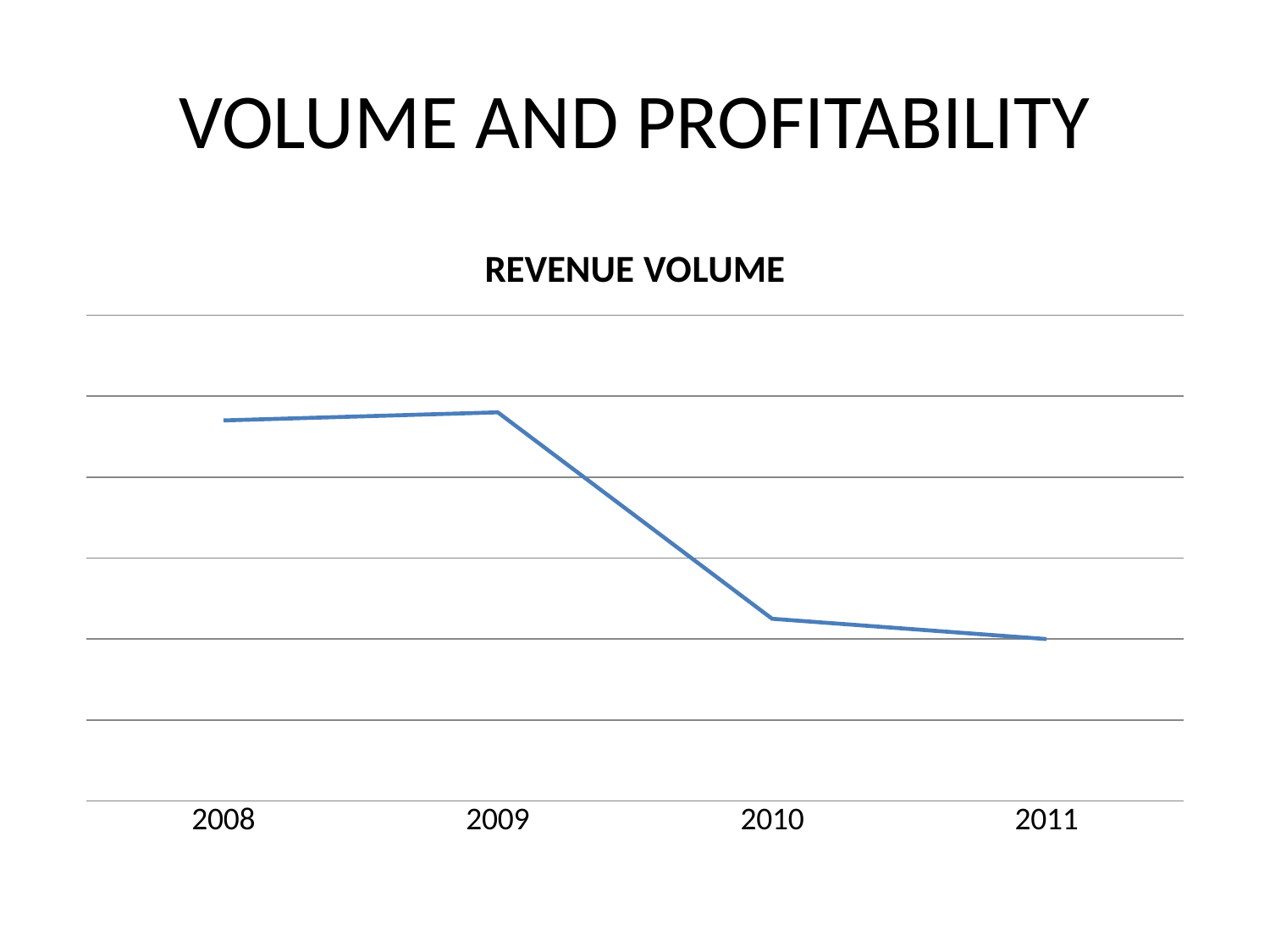
How many years are plotted on the x axis of the chart? 4 Is the revenue volume higher in 2008 or in 2011? 2008 What is the first year shown on the x axis? 2008 What type of chart is shown on the slide? line chart Overall, does the revenue volume rise or fall from 2008 to 2011? fall Which year has the lowest revenue volume? 2011 Which year has the highest revenue volume? 2009 What is the title of the chart? REVENUE VOLUME Does the revenue volume rise or fall between 2008 and 2009? rise Is the revenue volume higher in 2009 or in 2010? 2009 Does the revenue volume rise or fall between 2009 and 2010? fall